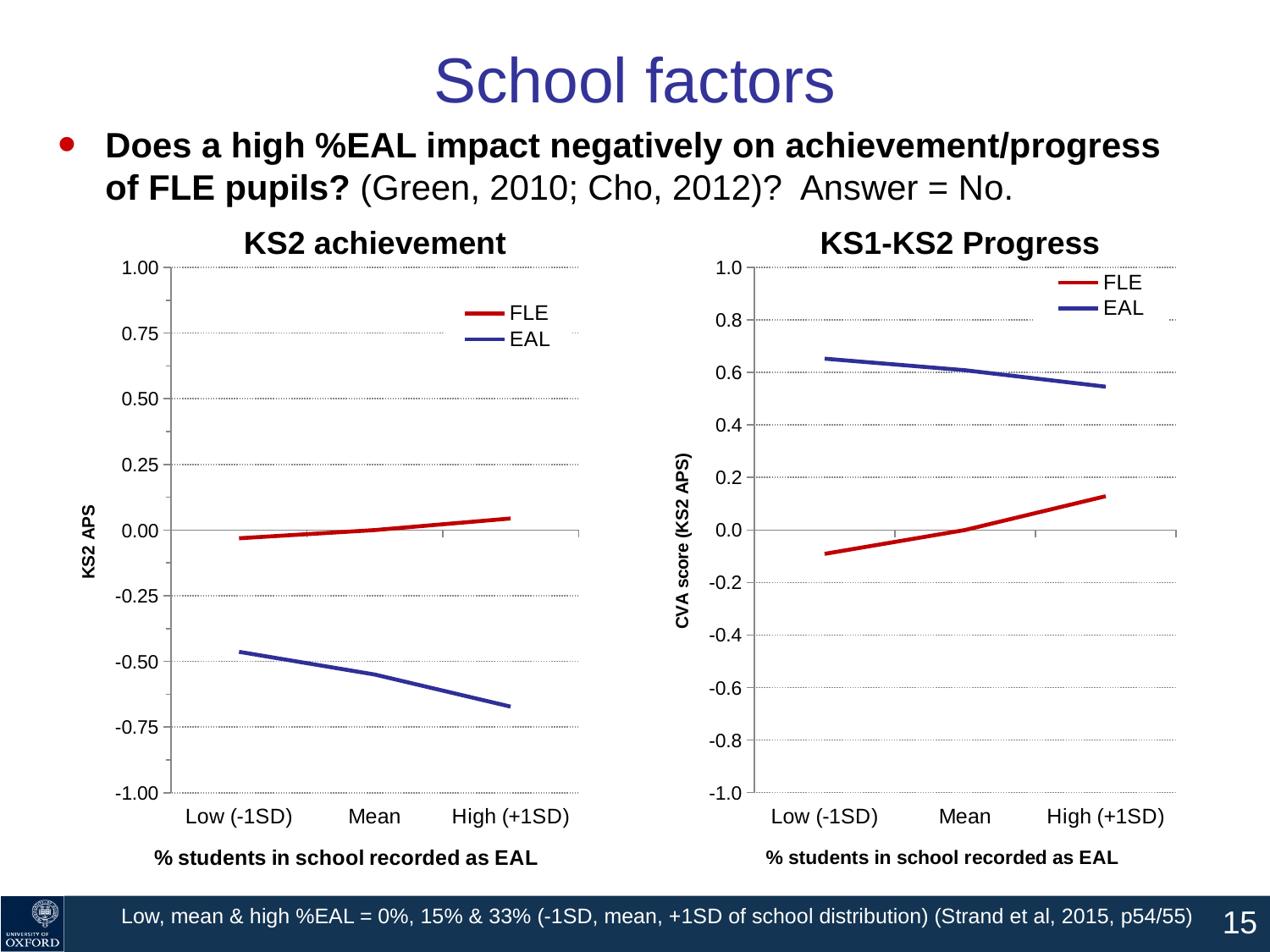
In the KS1-KS2 Progress chart, is the FLE value at High (+1SD) greater or less than 0.0? greater In the KS1-KS2 Progress chart, is the EAL value at Low (-1SD) greater or less than 0.6? greater What is the y-axis label of the KS1-KS2 Progress chart? CVA score (KS2 APS) In the KS1-KS2 Progress chart, does the EAL line rise or fall along the x axis? fall In the KS1-KS2 Progress chart, which series has the higher value at High (+1SD), FLE or EAL? EAL In the KS2 achievement chart, does the EAL line rise or fall from Low (-1SD) to High (+1SD)? fall In the KS2 achievement chart, is the EAL value at High (+1SD) greater or less than -0.50? less How many categories are shown on the x axis of the KS2 achievement chart? 3 In the KS2 achievement chart, which series has the higher value at Mean, FLE or EAL? FLE How many series does the legend of the KS1-KS2 Progress chart list? 2 In the KS1-KS2 Progress chart, does the FLE line rise or fall from Low (-1SD) to High (+1SD)? rise What kind of chart is the KS2 achievement chart on the left? line chart